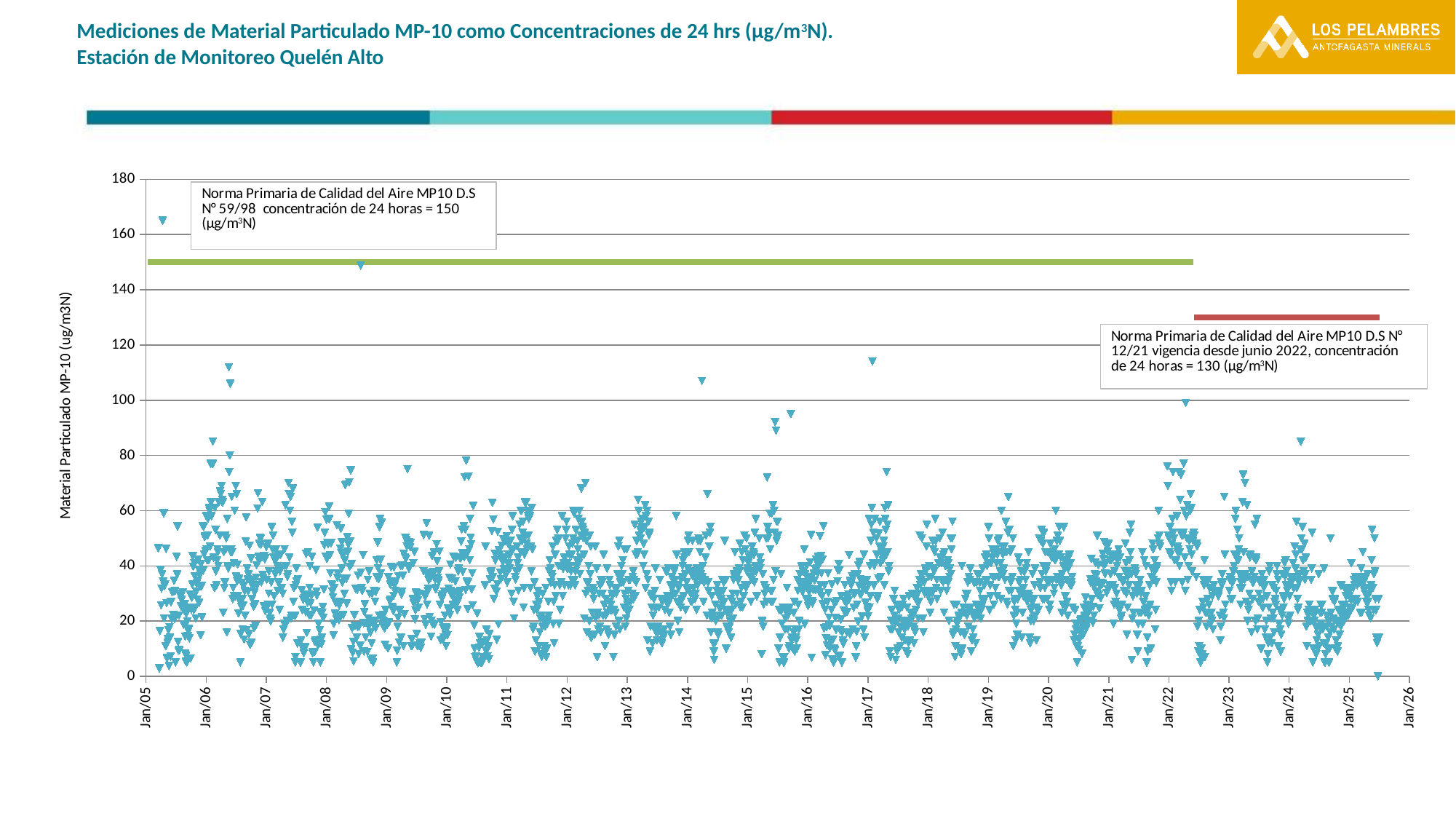
How many year tick labels are shown on the x axis, from Jan/05 to Jan/26? 22 What is the maximum value shown on the y axis? 180 Is the isolated high point near Jan/14 greater or less than 120? less What is the 24-hour concentration limit stated for Norma Primaria de Calidad del Aire MP10 D.S Nº 59/98? 150 (µg/m³N) Which norm has the higher 24-hour concentration limit, D.S Nº 59/98 or D.S Nº 12/21? D.S Nº 59/98 What kind of chart is shown on the slide? scatter chart What is the label of the y axis? Material Particulado MP-10 (ug/m3N) What is the 24-hour concentration limit stated for Norma Primaria de Calidad del Aire MP10 D.S Nº 12/21? 130 (µg/m³N) By how much does the D.S Nº 59/98 limit (150) exceed the D.S Nº 12/21 limit (130)? 20 Is the highest measured point, near Jan/05, greater or less than 160? greater Is the isolated high point near Jan/17 greater or less than 100? greater Since when has the D.S Nº 12/21 norm been in force according to the slide? junio 2022